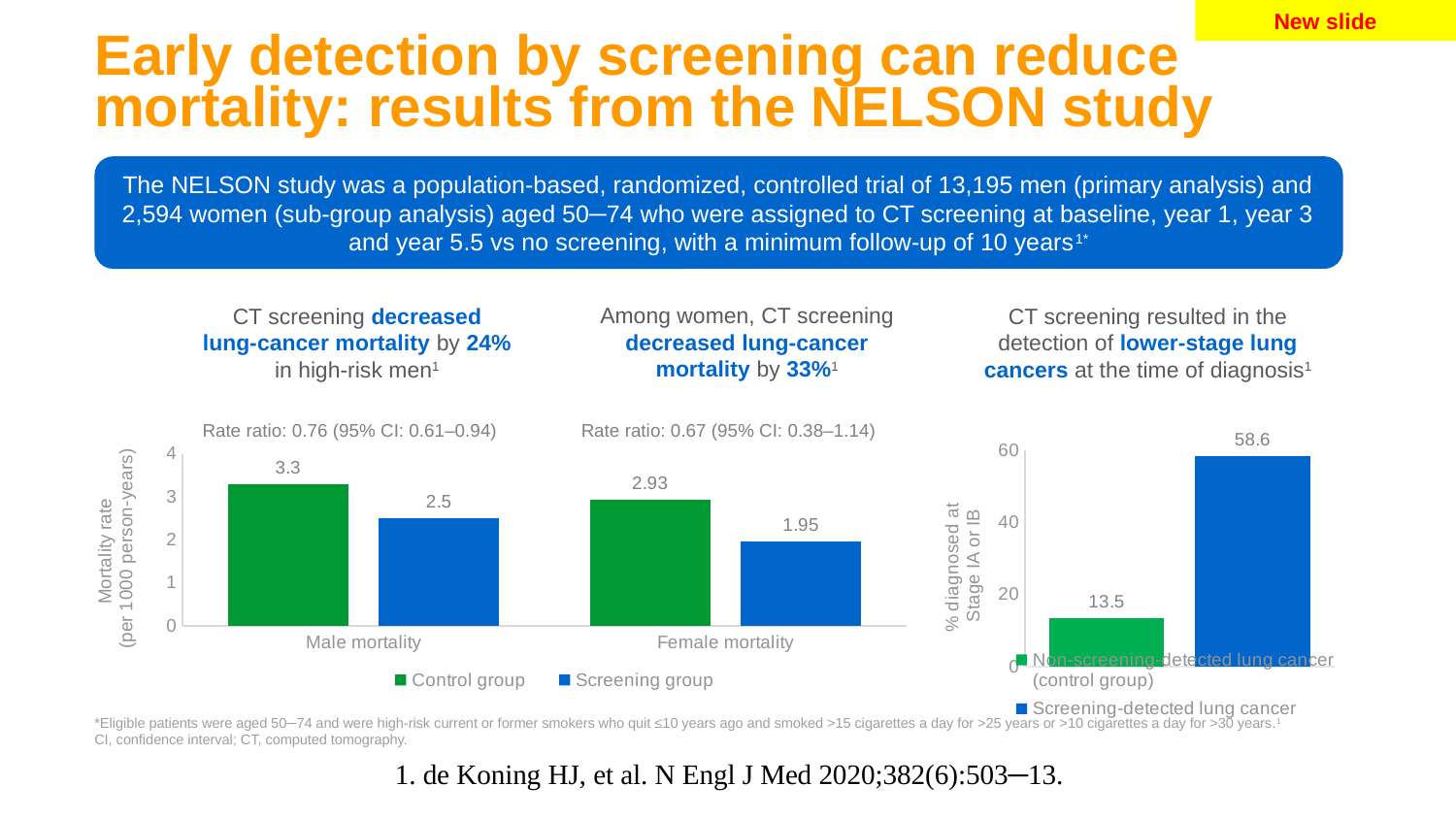
On the mortality rate chart, what is the mortality rate for the control group in the Male mortality category? 3.3 On the mortality rate chart, what is the difference between the control group and screening group values for Male mortality? 0.8 On the mortality rate chart, what is the mortality rate for the screening group in the Female mortality category? 1.95 On the mortality rate chart, which bar has the lowest value? Screening group, Female mortality On the mortality rate chart, how many categories are shown on the x axis? 2 On the right-hand chart (% diagnosed at Stage IA or IB), what is the value for non-screening-detected lung cancer (control group)? 13.5 On the mortality rate chart, what colour represents the screening group? Blue What kind of chart is the mortality rate chart on the left? Bar chart On the mortality rate chart, which group has the higher value for Female mortality, the control group or the screening group? Control group On the right-hand chart (% diagnosed at Stage IA or IB), what is the difference between the screening-detected and non-screening-detected values? 45.1 On the right-hand chart (% diagnosed at Stage IA or IB), what is the value for screening-detected lung cancer? 58.6 On the mortality rate chart, how many series does the legend list? 2